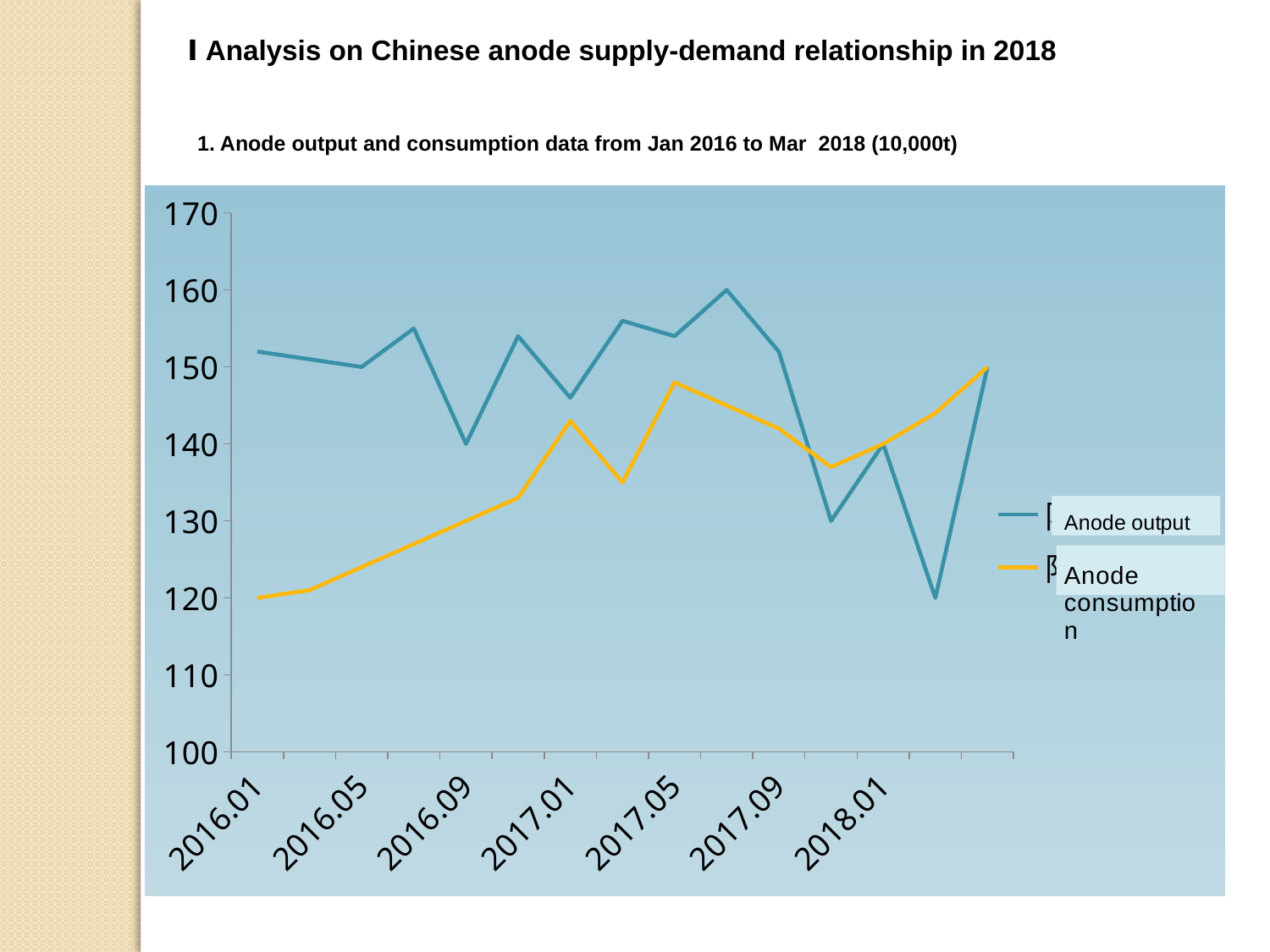
At 2016.01, which series has the higher value, Anode output or Anode consumption? Anode output What are the two series named in the legend? Anode output and Anode consumption Which series reaches the higher peak value over the whole period? Anode output What kind of chart is shown on the slide? line chart Is the value for Anode consumption at 2017.05 greater or less than 140? greater How many labels are shown on the x axis? 7 Does Anode consumption generally rise or fall from 2016.01 to the end of the period? rise Is the value for Anode consumption at 2016.09 greater or less than 140? less How many series does the legend list? 2 Is the value for Anode output at 2016.01 greater or less than 150? greater At 2017.09, which series has the higher value, Anode output or Anode consumption? Anode output